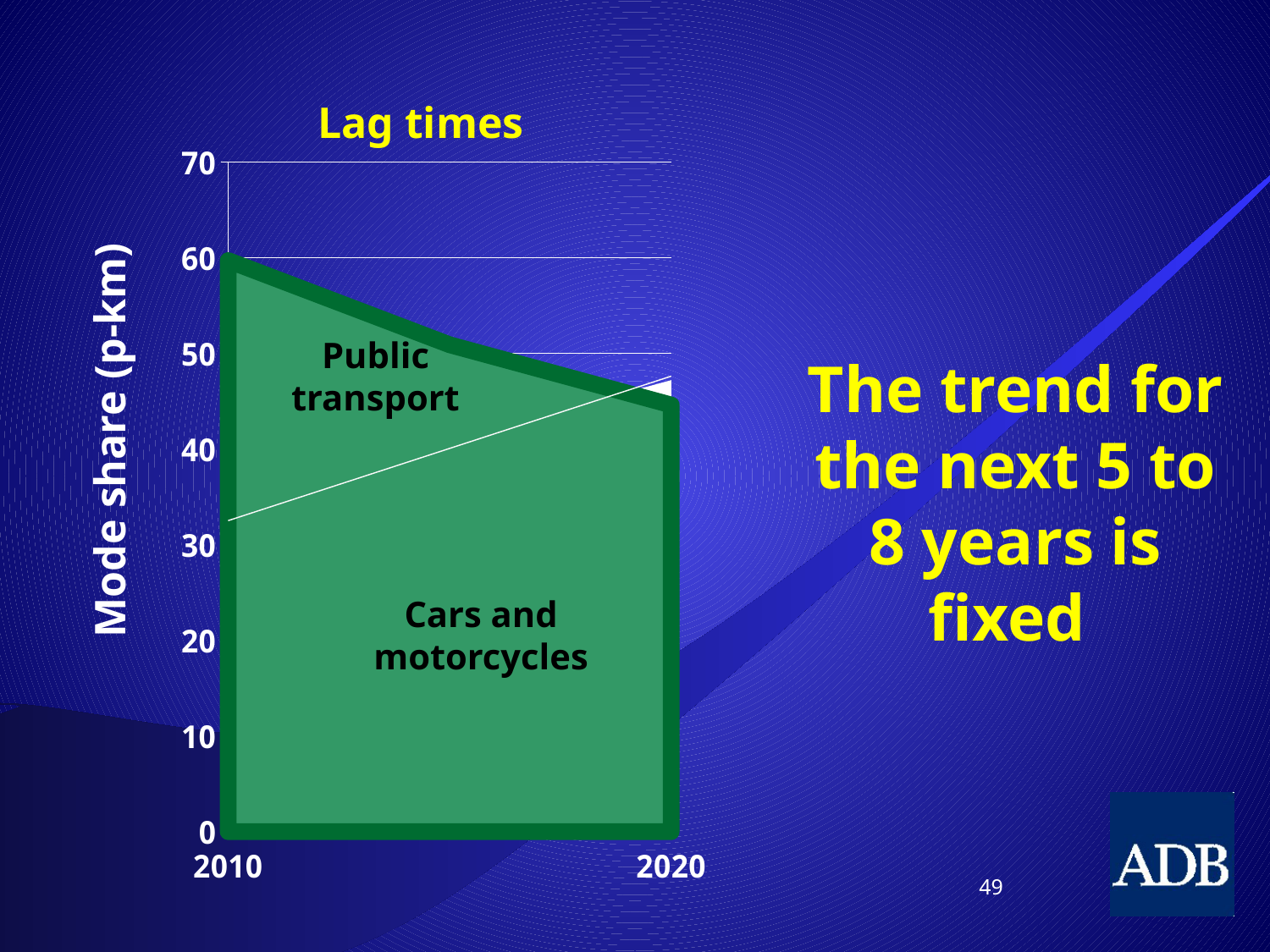
Is the value of the thin white line in 2010 greater or less than 30? greater What is the title of the chart? Lag times Is the value of the top edge of the green area in 2020 greater or less than 40? greater What kind of chart is shown on the slide? area chart In 2010, which is higher: the top edge of the green area or the thin white line? the top edge of the green area Does the thin white line rise or fall from 2010 to 2020? rise Does the top edge of the green area rise or fall from 2010 to 2020? fall Is the value of the top edge of the green area in 2020 greater or less than 50? less What is the label on the vertical axis of the chart? Mode share (p-km) What is the first year shown on the horizontal axis? 2010